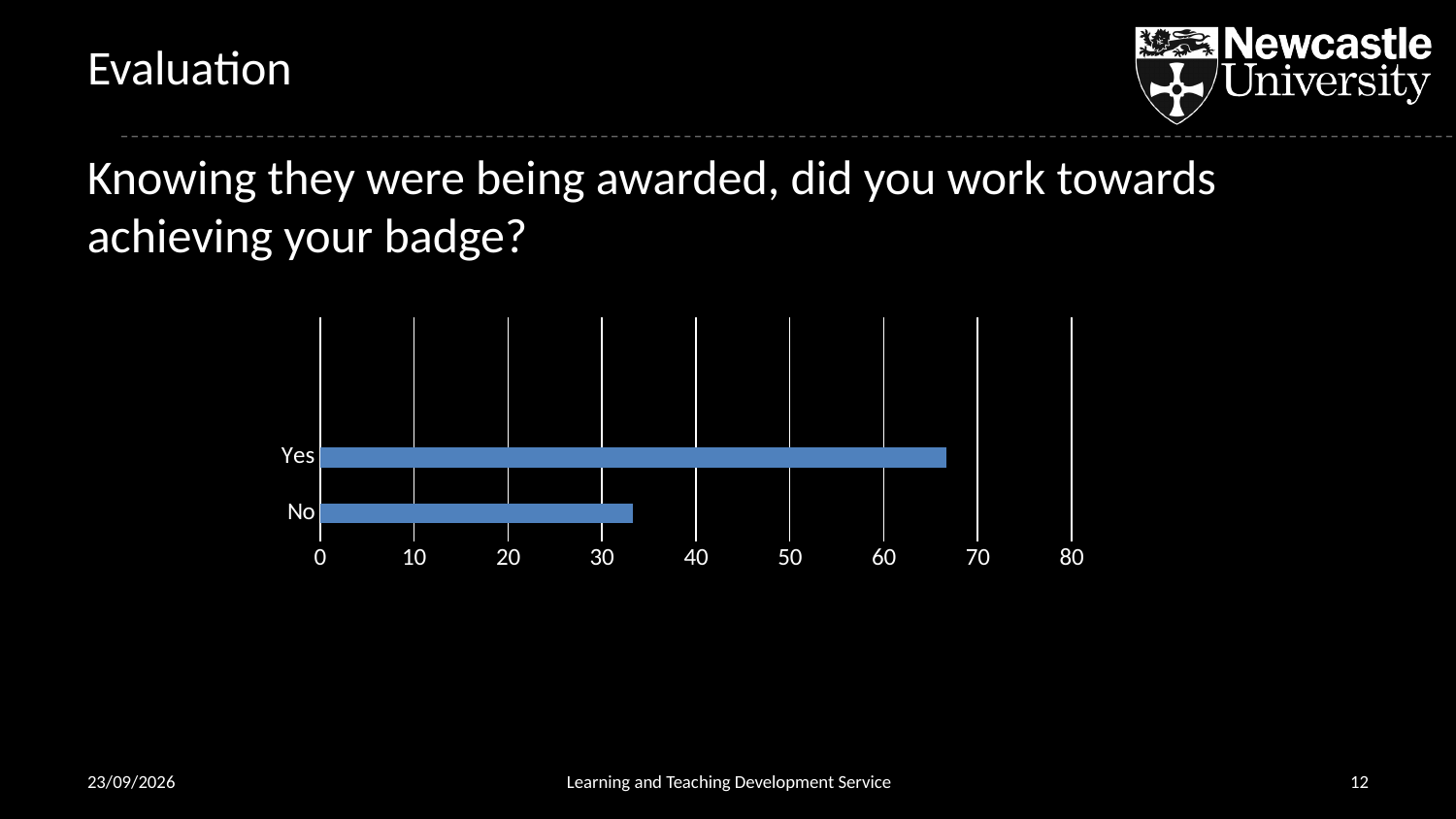
Is the value for Yes greater or less than 70? less What is the highest value shown on the horizontal axis? 80 Is the value for Yes greater or less than 60? greater Is the value for No greater or less than 20? greater Which category has the highest value? Yes Which category has the lowest value? No What colour are the bars in the chart? blue How many categories does the chart show? 2 Which is larger, the value for Yes or the value for No? Yes What kind of chart is shown on the slide? bar chart